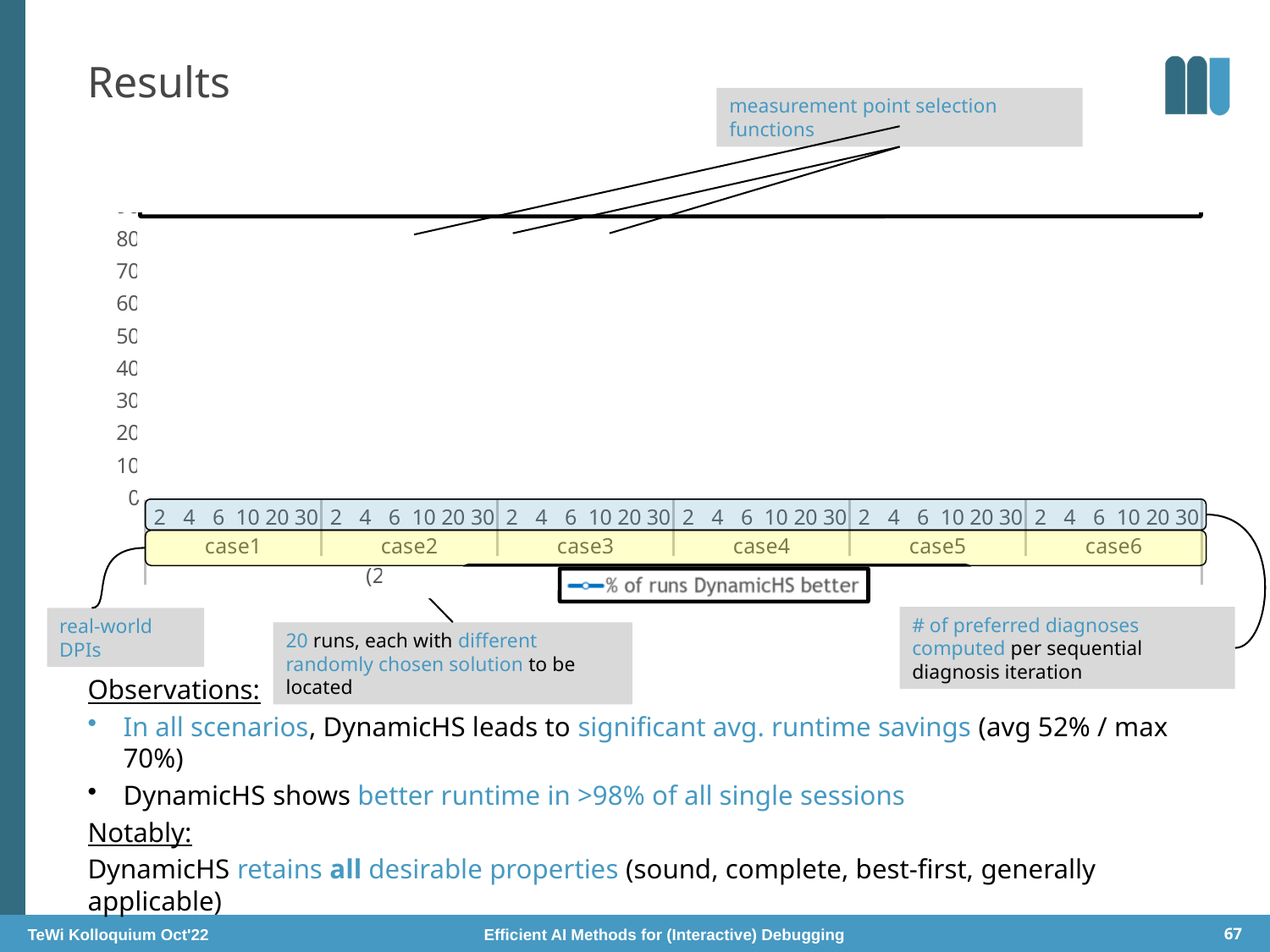
What are the x-axis tick values listed within each case group of the chart? 2, 4, 6, 10, 20, 30 How many x-axis points are there within each case group of the chart? 6 How many x-axis points are there in total across all case groups of the chart? 36 What is the label of the last case group on the x axis of the chart? case6 How many series does the chart's legend list? 1 How many case groups are labelled along the x axis of the chart? 6 What is the name of the series shown in the chart's legend? % of runs DynamicHS better What is the label of the first case group on the x axis of the chart? case1